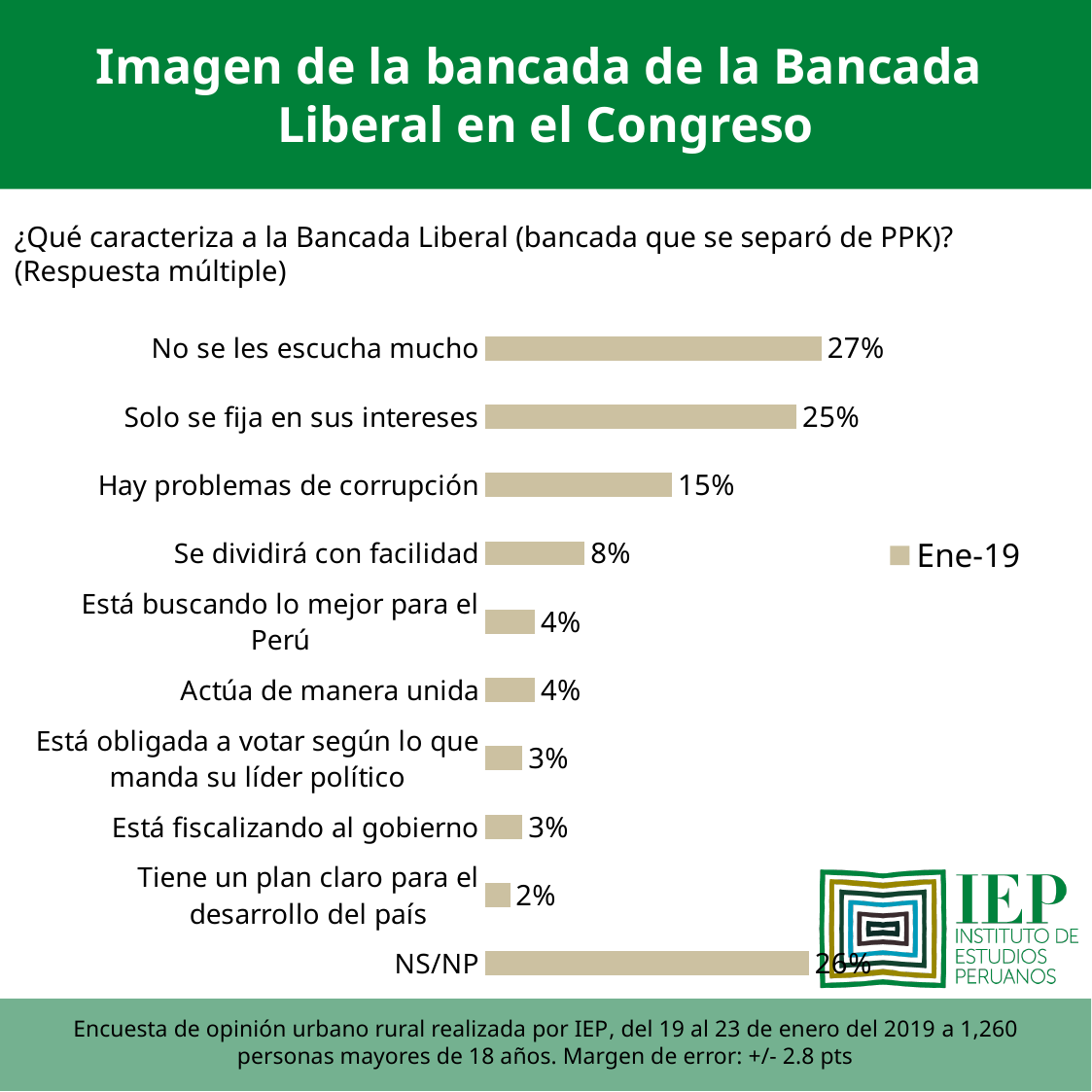
How many categories are shown in the chart? 10 Which is larger, "Se dividirá con facilidad" or "Actúa de manera unida"? Se dividirá con facilidad What percentage of respondents said "No se les escucha mucho"? 27% How many series does the legend list? 1 What is the value for "Tiene un plan claro para el desarrollo del país"? 2% What kind of chart is shown on the slide? Bar chart What is the difference between "Solo se fija en sus intereses" and "Hay problemas de corrupción"? 10% What is the legend entry shown on the chart? Ene-19 Which category has the lowest value? Tiene un plan claro para el desarrollo del país What is the value for "Se dividirá con facilidad"? 8% What is the value for "Hay problemas de corrupción"? 15% Which category has the highest value? No se les escucha mucho